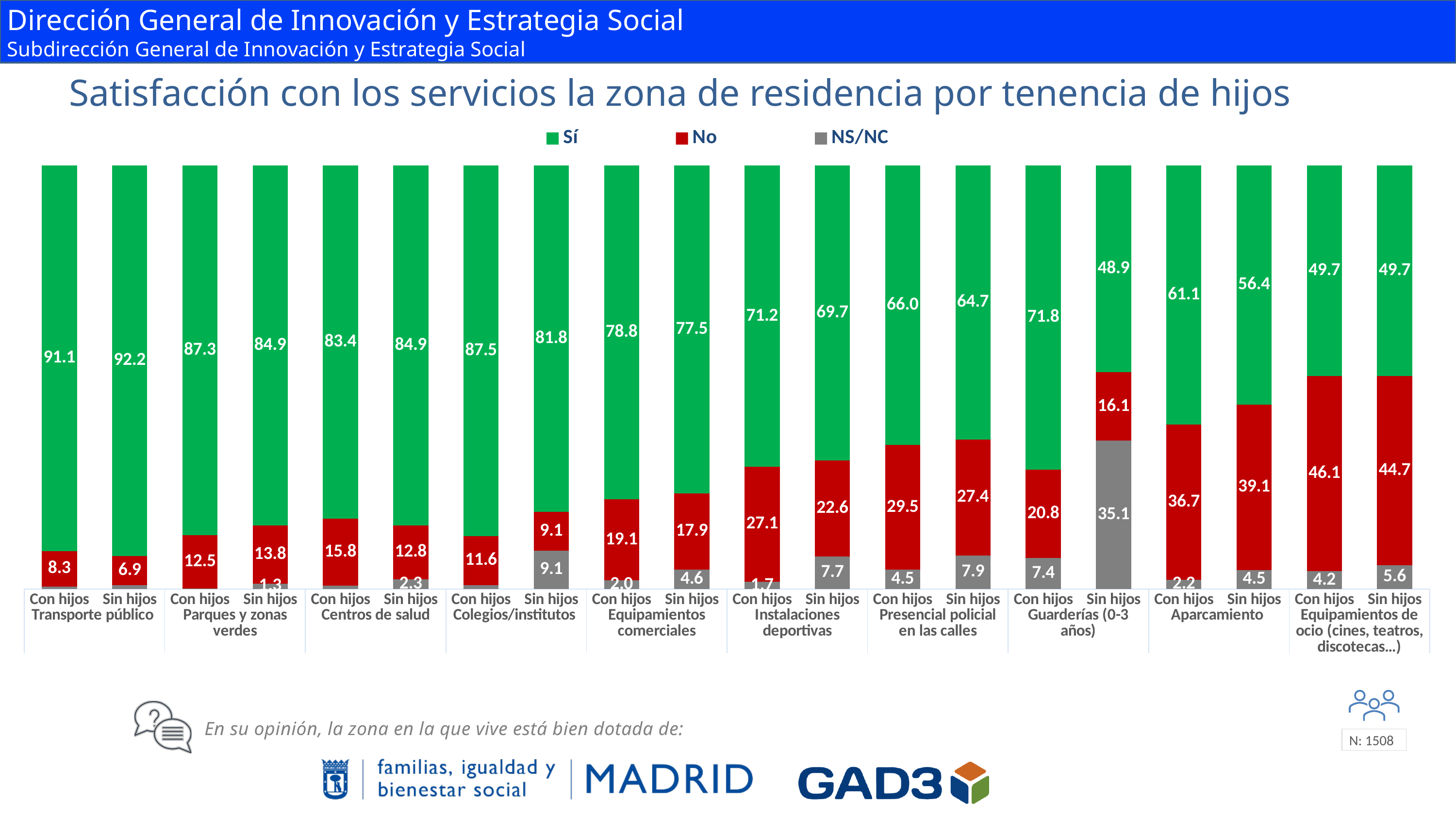
What is the "No" value for "Con hijos" under "Equipamientos de ocio (cines, teatros, discotecas...)"? 46.1 What is the difference between the "Sí" values for "Con hijos" and "Sin hijos" under "Guarderías (0-3 años)"? 22.9 Which bar has the highest "Sí" value? Sin hijos, Transporte público How many bars are plotted in the chart? 20 What is the "No" value for "Sin hijos" under "Aparcamiento"? 39.1 Which colour represents the "No" series in the legend? Red What is the "Sí" value for "Con hijos" under "Transporte público"? 91.1 Which is larger: the "No" value for "Con hijos" or for "Sin hijos" under "Instalaciones deportivas"? Con hijos Which bar has the lowest "Sí" value? Sin hijos, Guarderías (0-3 años) How many series does the legend list? 3 What is the "NS/NC" value for "Sin hijos" under "Guarderías (0-3 años)"? 35.1 What kind of chart is shown on the slide? Stacked bar chart